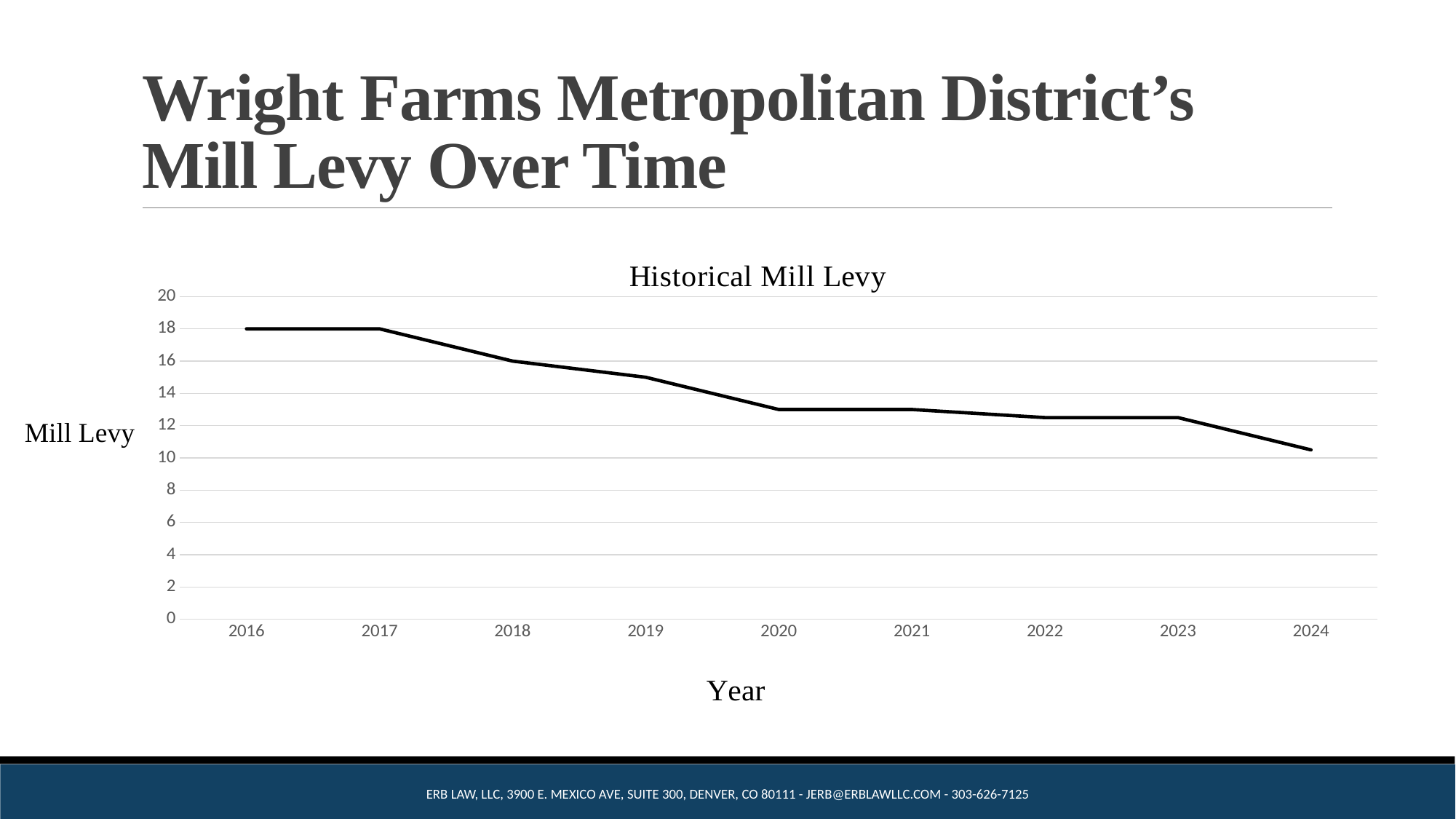
Does the mill levy generally rise or fall from 2016 to 2024? fall What type of chart is shown on the slide? line chart What is the title of the chart? Historical Mill Levy How many years are plotted on the x axis of the chart? 9 Is the mill levy for 2020 greater or less than 14? less What is the label on the vertical axis of the chart? Mill Levy Which year has the lowest mill levy? 2024 Which year has a higher mill levy, 2017 or 2024? 2017 What is the mill levy value for 2016? 18 What is the mill levy value for 2018? 16 Is the mill levy for 2024 greater or less than 12? less Is the mill levy for 2019 greater or less than 14? greater